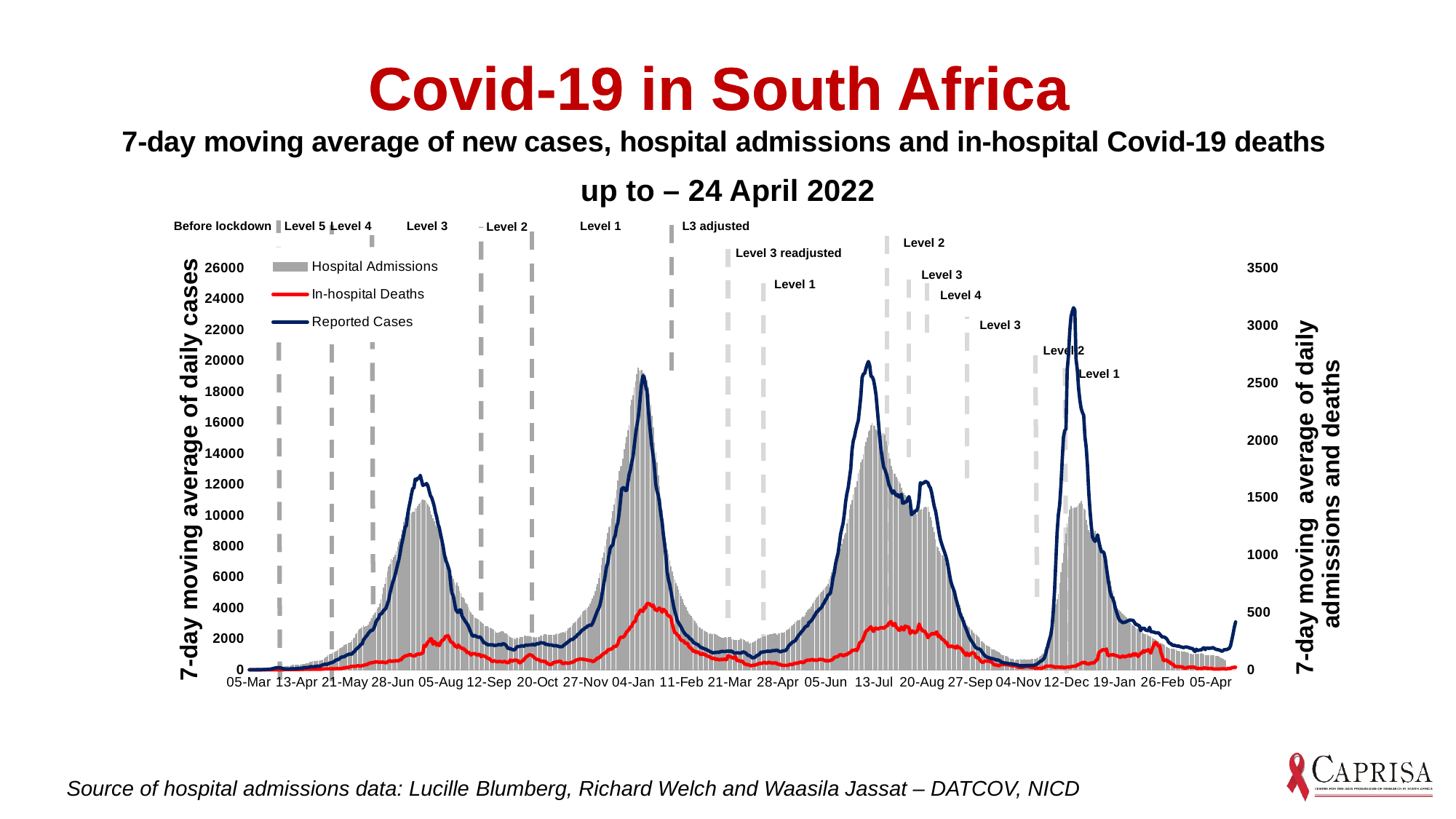
Between 19-Jan and 26-Feb, does the Reported Cases line rise or fall? Fall Near which x-axis label does the Reported Cases line reach its highest peak? 12-Dec On the right-hand axis, is the peak of the In-hospital Deaths line near 04-Jan greater or less than 1000? less What colour is the Reported Cases line? Dark blue Which is higher: the Reported Cases peak near 04-Jan or the Reported Cases peak near 05-Aug? The peak near 04-Jan How many series does the legend list? 3 Is the highest peak of the Reported Cases line (near 12-Dec) greater or less than 20000? greater Which series is drawn as grey bars according to the legend? Hospital Admissions Is the peak of the Reported Cases line near 04-Jan greater or less than 16000? greater What type of chart is shown on the slide? A combination of a bar chart and line chart Which is higher: the Hospital Admissions peak near 04-Jan or the Hospital Admissions peak near 13-Jul? The peak near 04-Jan